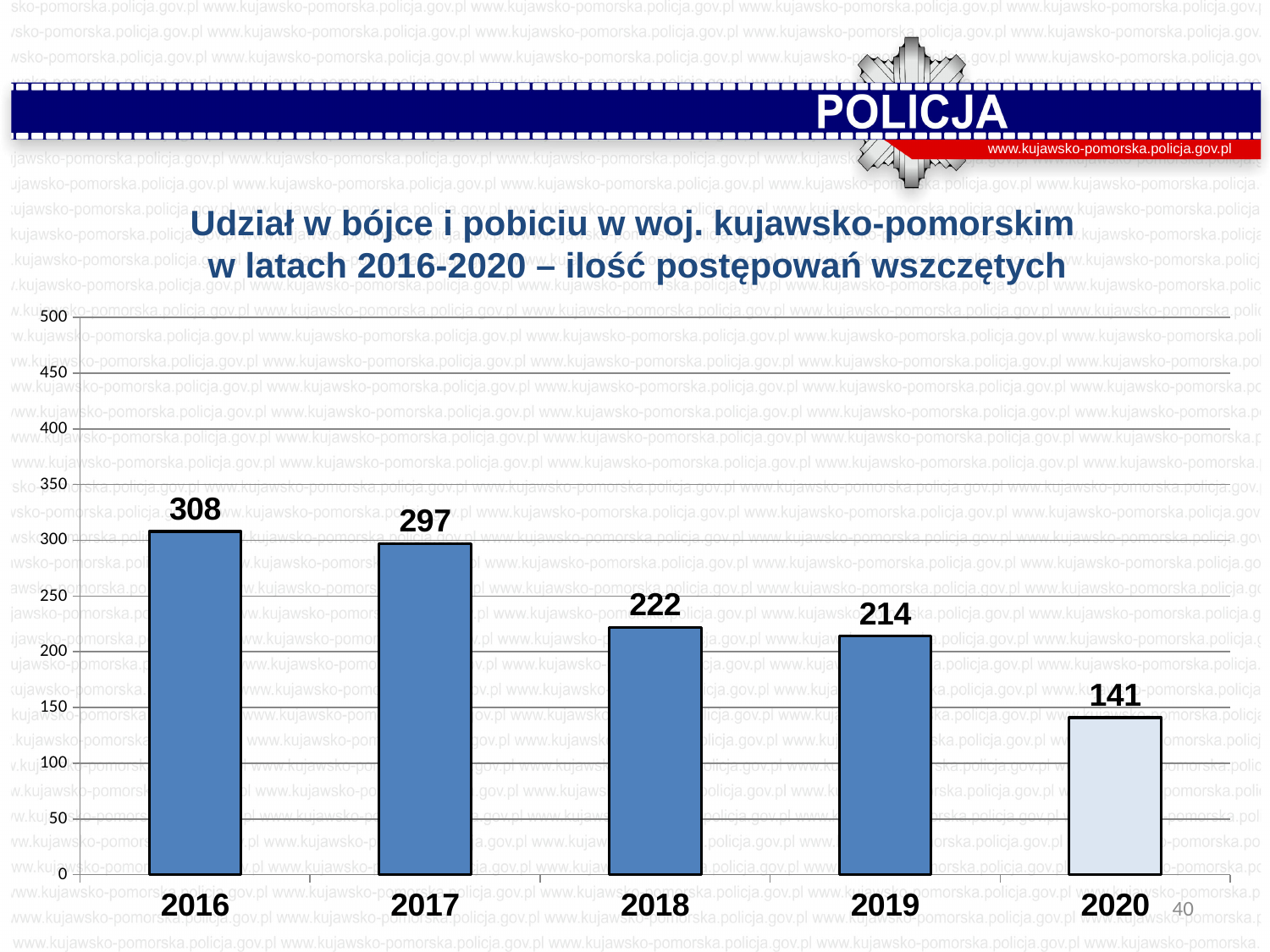
Do the values rise or fall from 2016 to 2020? fall What is the value for 2016? 308 What is the difference between the values for 2016 and 2017? 11 What is the difference between the values for 2019 and 2020? 73 Is the value for 2017 greater or less than 250? greater Which is larger, the value for 2018 or the value for 2019? 2018 What is the value for 2018? 222 What is the value for 2020? 141 How many years are shown on the x axis? 5 Which year has the lowest value? 2020 What kind of chart is shown on the slide? bar chart Which year has the highest value? 2016